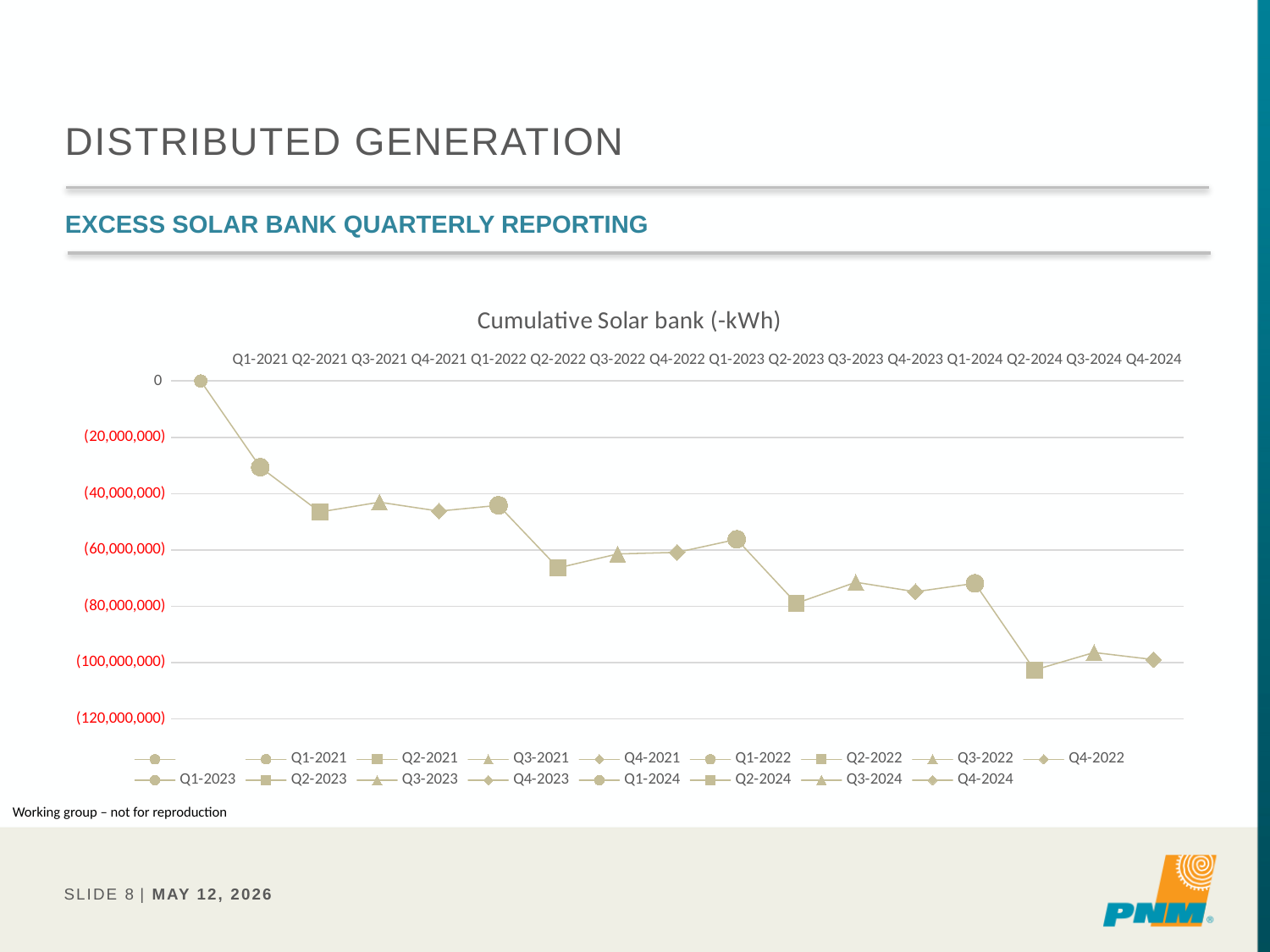
Is the value for Q2-2021 greater or less than (40,000,000)? less Which has the larger value, Q1-2021 or Q2-2021? Q1-2021 Is the value for Q2-2024 greater or less than (100,000,000)? less What kind of chart is shown on the slide? line chart Is the value for Q2-2022 greater or less than (60,000,000)? less Do the values in the chart generally rise or fall from left to right along the x axis? fall Which has the larger value, Q1-2023 or Q2-2023? Q1-2023 What is the title of the chart? Cumulative Solar bank (-kWh) How many quarter labels are shown along the x axis of the chart? 16